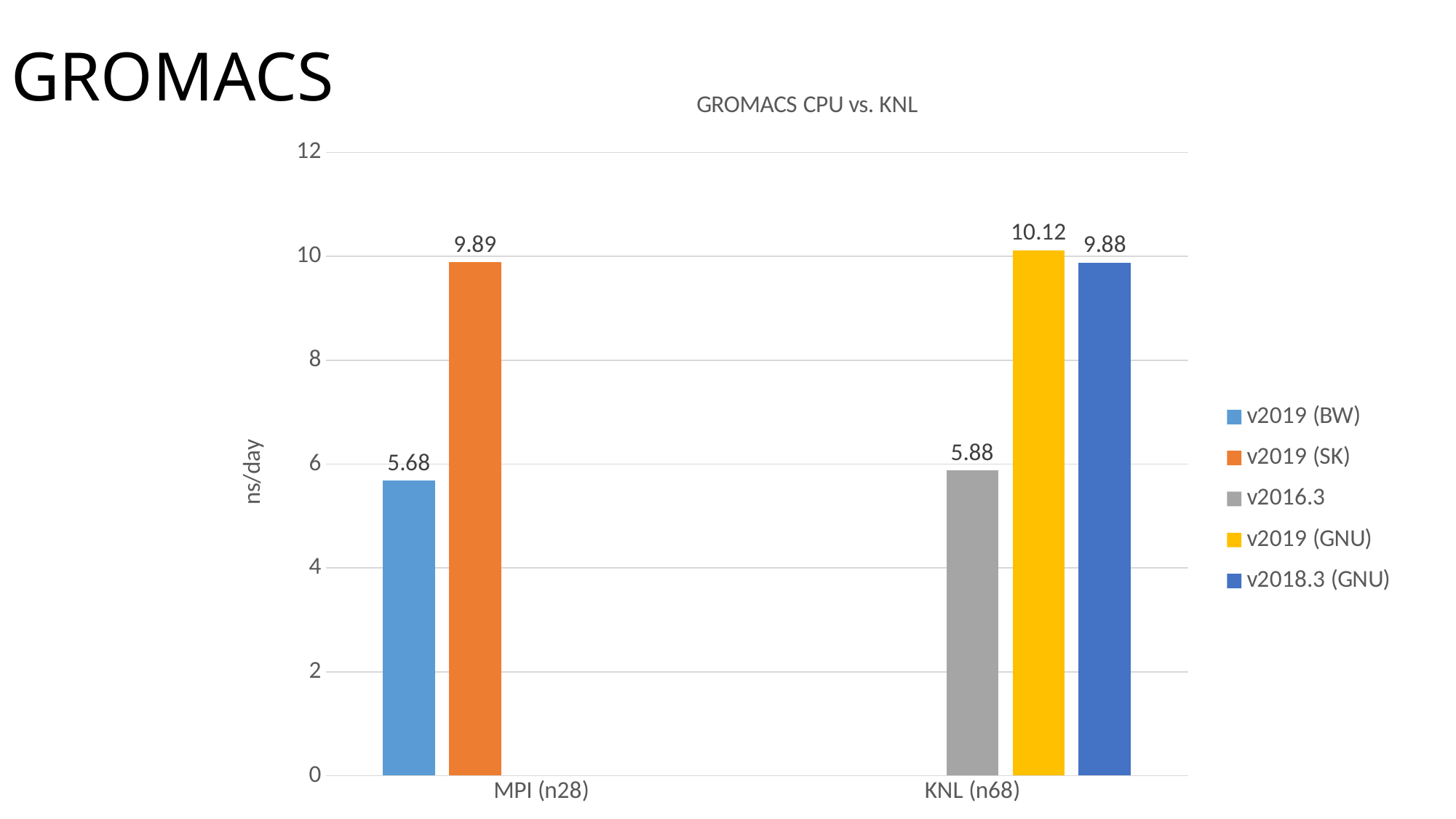
What is the value for v2019 (BW) in the MPI (n28) category? 5.68 What is the difference between the v2019 (SK) value for MPI (n28) and the v2019 (BW) value for MPI (n28)? 4.21 What is the value for v2018.3 (GNU) in the KNL (n68) category? 9.88 Which series has the lowest value on the chart? v2019 (BW) What kind of chart is shown on the slide? Bar chart How many series does the legend list? 5 Which series has the highest value on the chart? v2019 (GNU) Which is larger: the v2019 (GNU) value for KNL (n68) or the v2016.3 value for KNL (n68)? v2019 (GNU) What is the value for v2019 (GNU) in the KNL (n68) category? 10.12 What is the value for v2019 (SK) in the MPI (n28) category? 9.89 What is the value for v2016.3 in the KNL (n68) category? 5.88 What is the title of the chart? GROMACS CPU vs. KNL